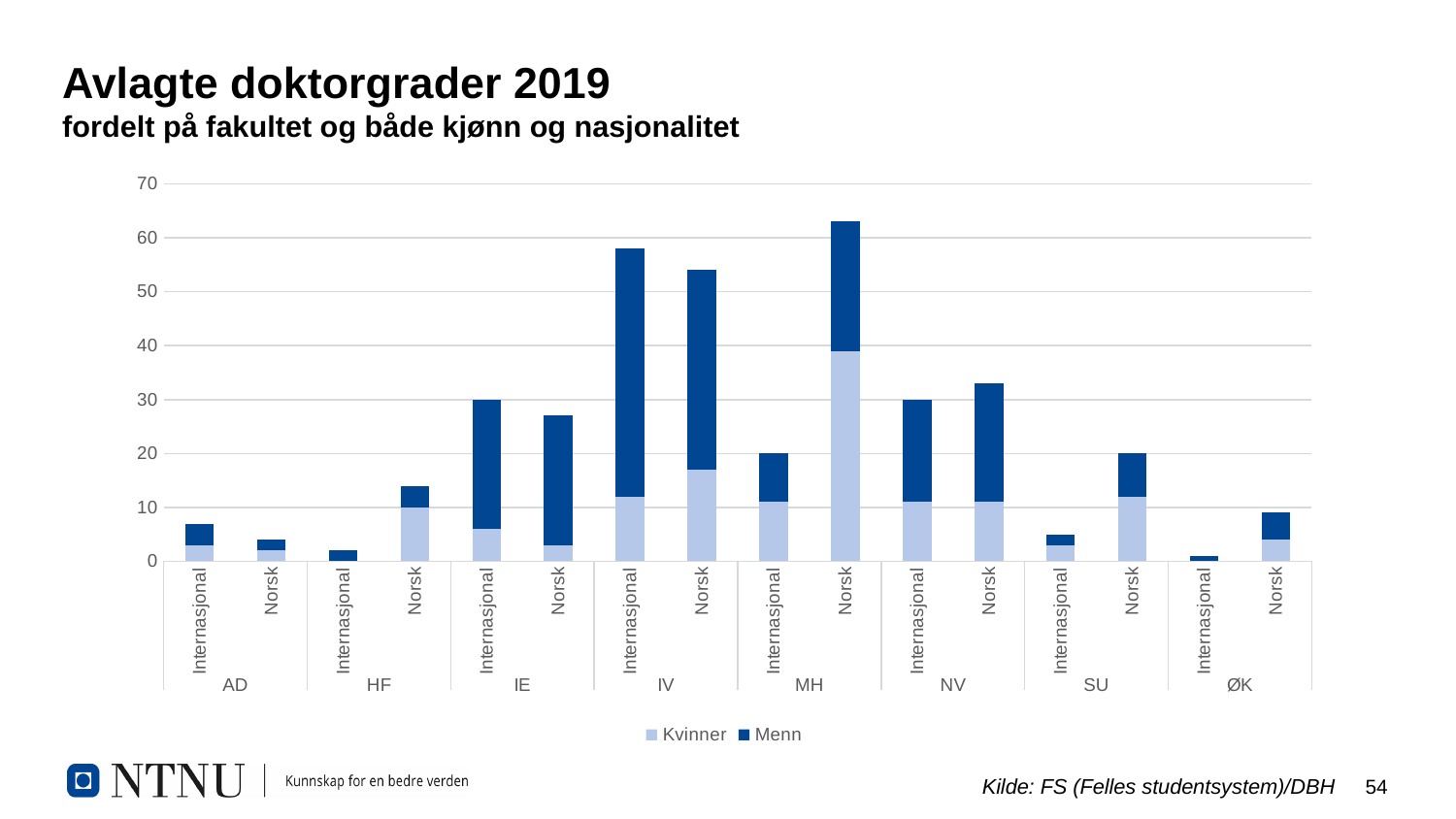
Is the total for HF Internasjonal greater or less than 10? less How many faculties are shown along the x axis? 8 Which is larger, the total for MH Norsk or IV Internasjonal? MH Norsk Which is larger, the total for HF Norsk or HF Internasjonal? HF Norsk How many series does the legend list? 2 How many bars are plotted in the chart in total? 16 Which bar has the lowest total? ØK Internasjonal What are the two series named in the legend? Kvinner and Menn Is the total for IV Norsk greater or less than 50? greater Which bar has the highest total? MH Norsk Is the total for MH Norsk greater or less than 60? greater What kind of chart is shown on the slide? stacked bar chart